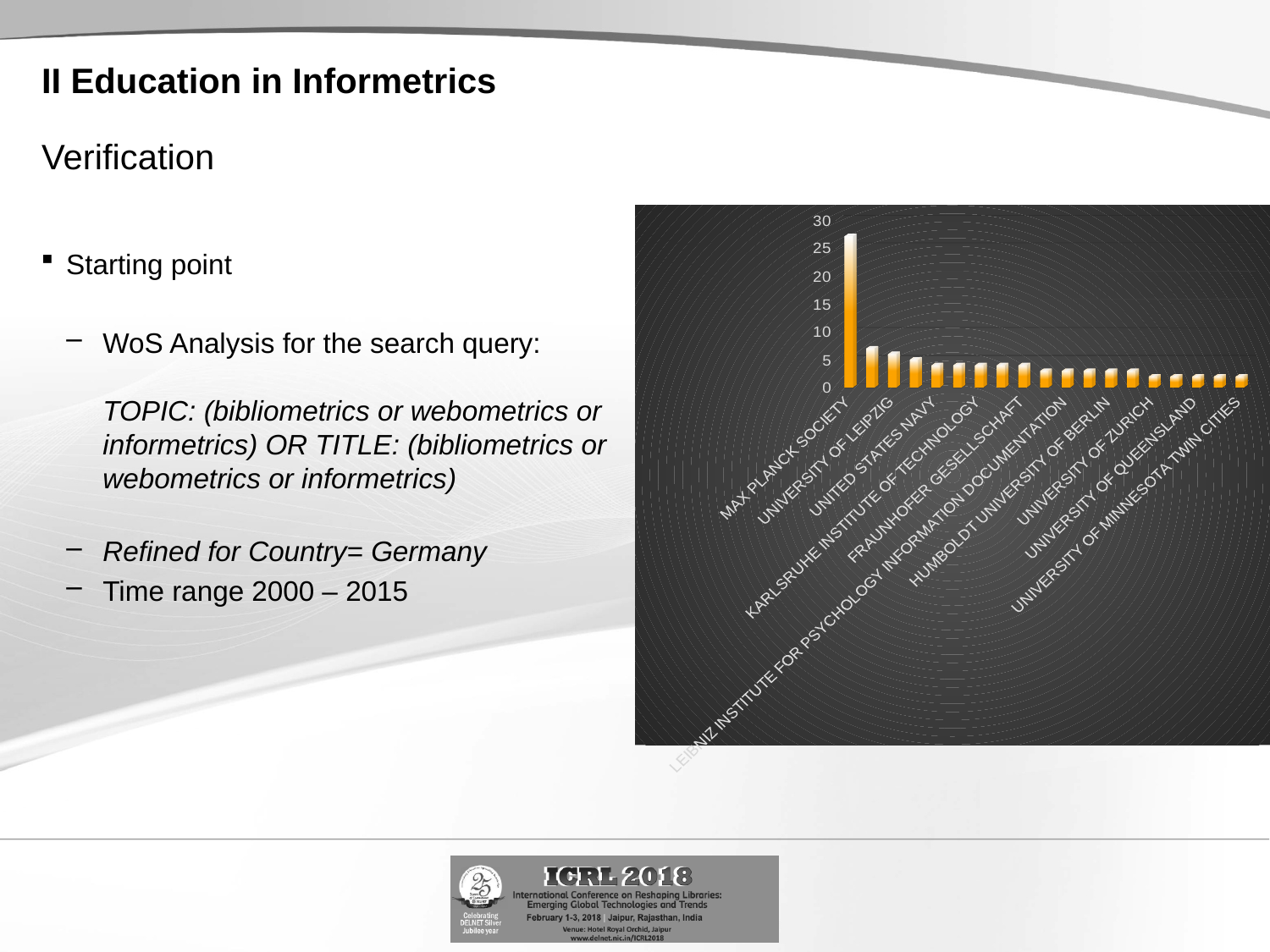
Is the value for UNIVERSITY OF LEIPZIG greater or less than 10? less Which is larger, the value for UNIVERSITY OF LEIPZIG or the value for UNIVERSITY OF ZURICH? UNIVERSITY OF LEIPZIG Which is larger, the value for MAX PLANCK SOCIETY or the value for UNIVERSITY OF LEIPZIG? MAX PLANCK SOCIETY What kind of chart is shown on the slide? bar chart Do the values rise or fall moving from left to right along the x axis? fall What colour are the bars in the chart? orange Is the value for UNIVERSITY OF MINNESOTA TWIN CITIES greater or less than 5? less Which category has the highest value in the chart? MAX PLANCK SOCIETY What is the highest tick value shown on the vertical axis? 30 Is the value for MAX PLANCK SOCIETY greater or less than 20? greater